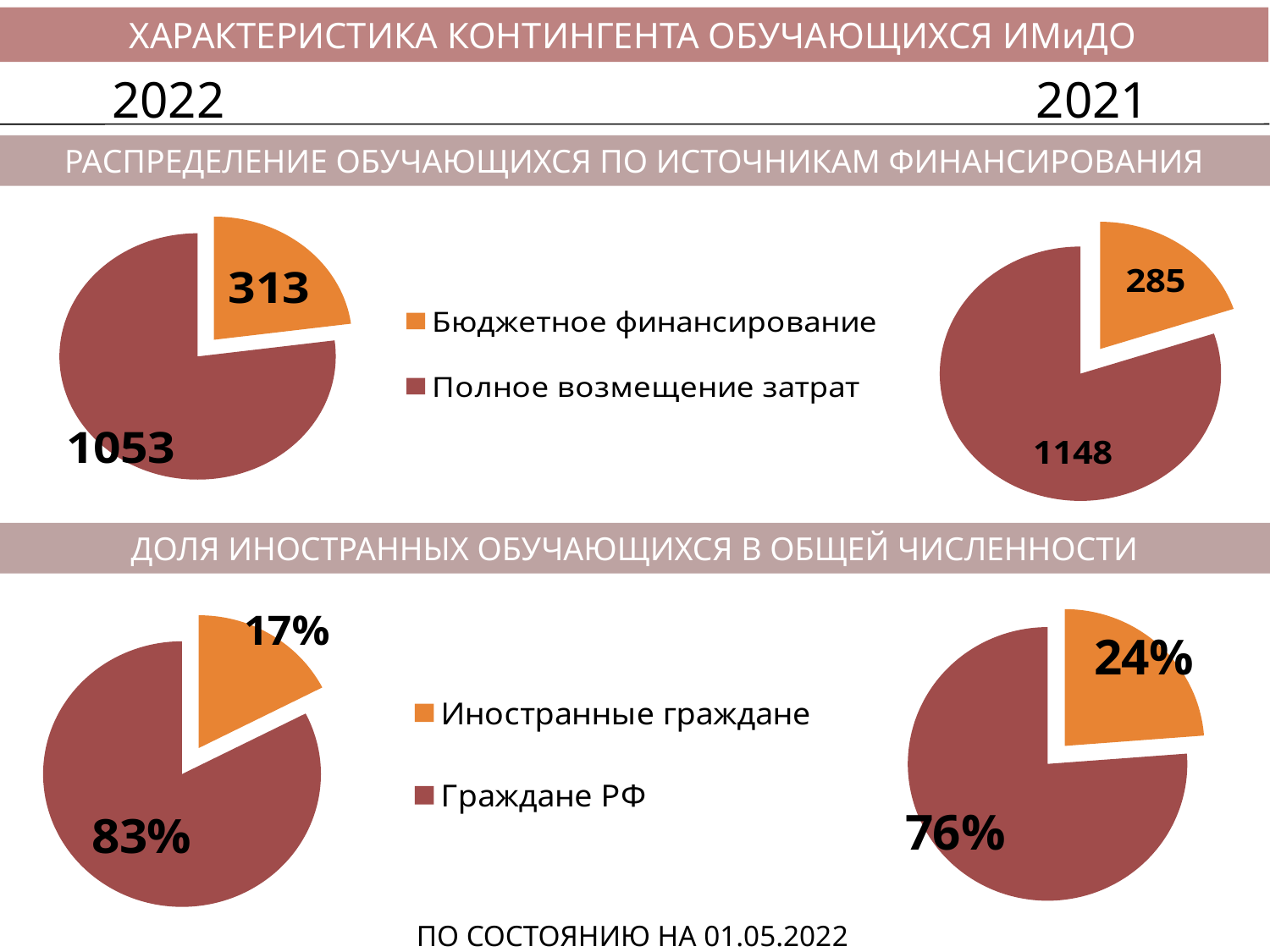
In the 2022 pie chart for distribution of students by funding source, what is the value for Бюджетное финансирование? 313 In the 2021 pie chart for distribution of students by funding source, what is the total of the two slices? 1433 In the 2021 pie chart for distribution of students by funding source, what is the value for Полное возмещение затрат? 1148 In the 2022 pie chart for distribution of students by funding source, which category is the largest? Полное возмещение затрат Comparing the 2022 and 2021 pie charts for share of foreign students, which year has the larger share of Иностранные граждане? 2021 In the 2022 pie chart for distribution of students by funding source, what is the value for Полное возмещение затрат? 1053 What type of chart is used for the distribution of students by funding source? Pie chart In the 2021 pie chart for share of foreign students, what percentage is shown for Граждане РФ? 76% In the 2021 pie chart for distribution of students by funding source, what is the value for Бюджетное финансирование? 285 In the 2022 pie chart for share of foreign students, what percentage is shown for Иностранные граждане? 17% In the 2022 pie chart for distribution of students by funding source, what is the difference between Полное возмещение затрат and Бюджетное финансирование? 740 How many entries does the legend for the share of foreign students charts list? 2